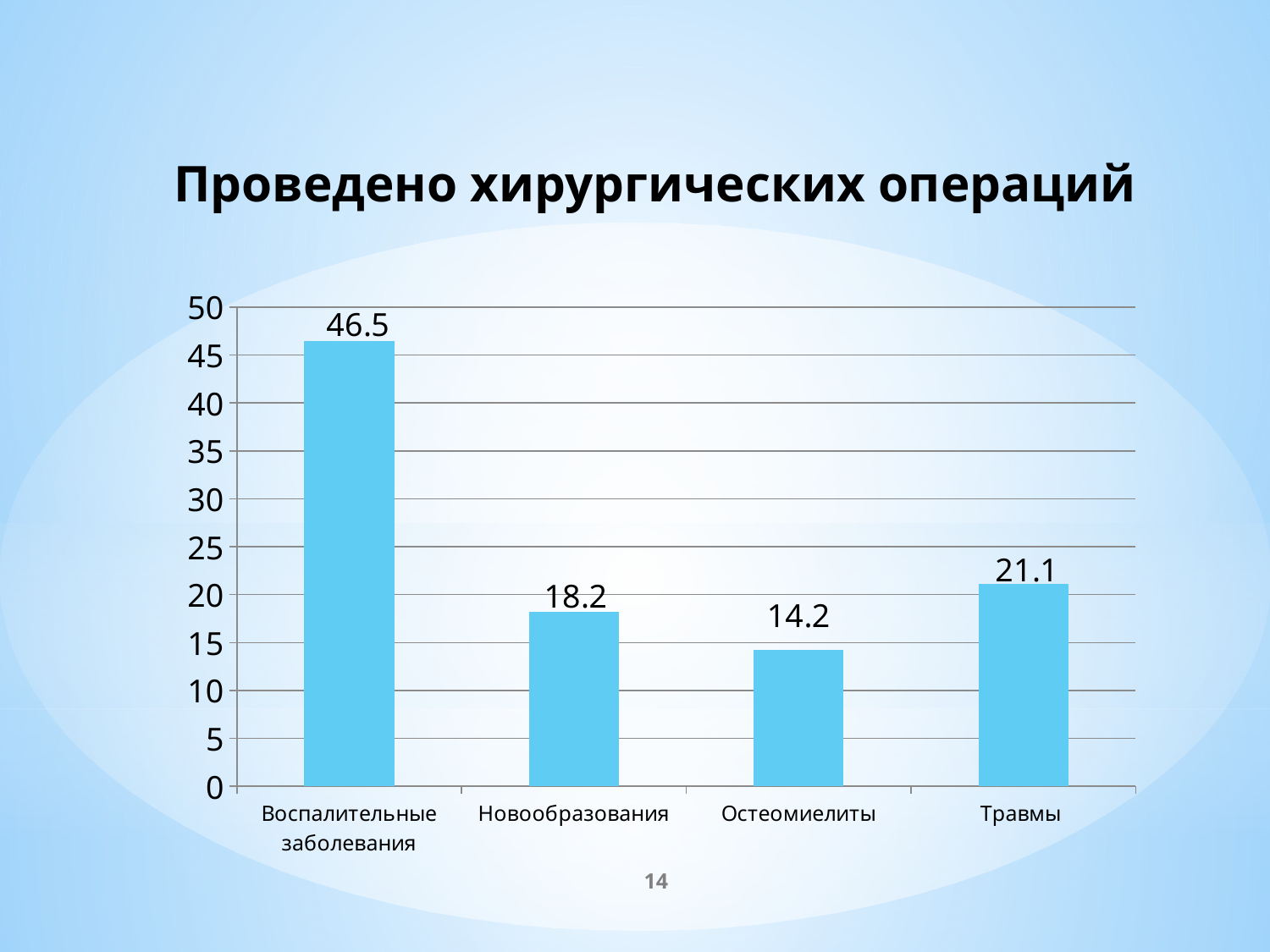
What is the value for Остеомиелиты? 14.2 Which category has the highest value? Воспалительные заболевания What is the difference between the values for Воспалительные заболевания and Травмы? 25.4 What is the value for Новообразования? 18.2 What is the value for Воспалительные заболевания? 46.5 Which is larger, the value for Травмы or the value for Новообразования? Травмы What kind of chart is shown on the slide? bar chart Is the value for Остеомиелиты greater or less than 15? less Which category has the lowest value? Остеомиелиты What is the value for Травмы? 21.1 What is the difference between the values for Новообразования and Остеомиелиты? 4.0 How many categories are shown on the chart? 4